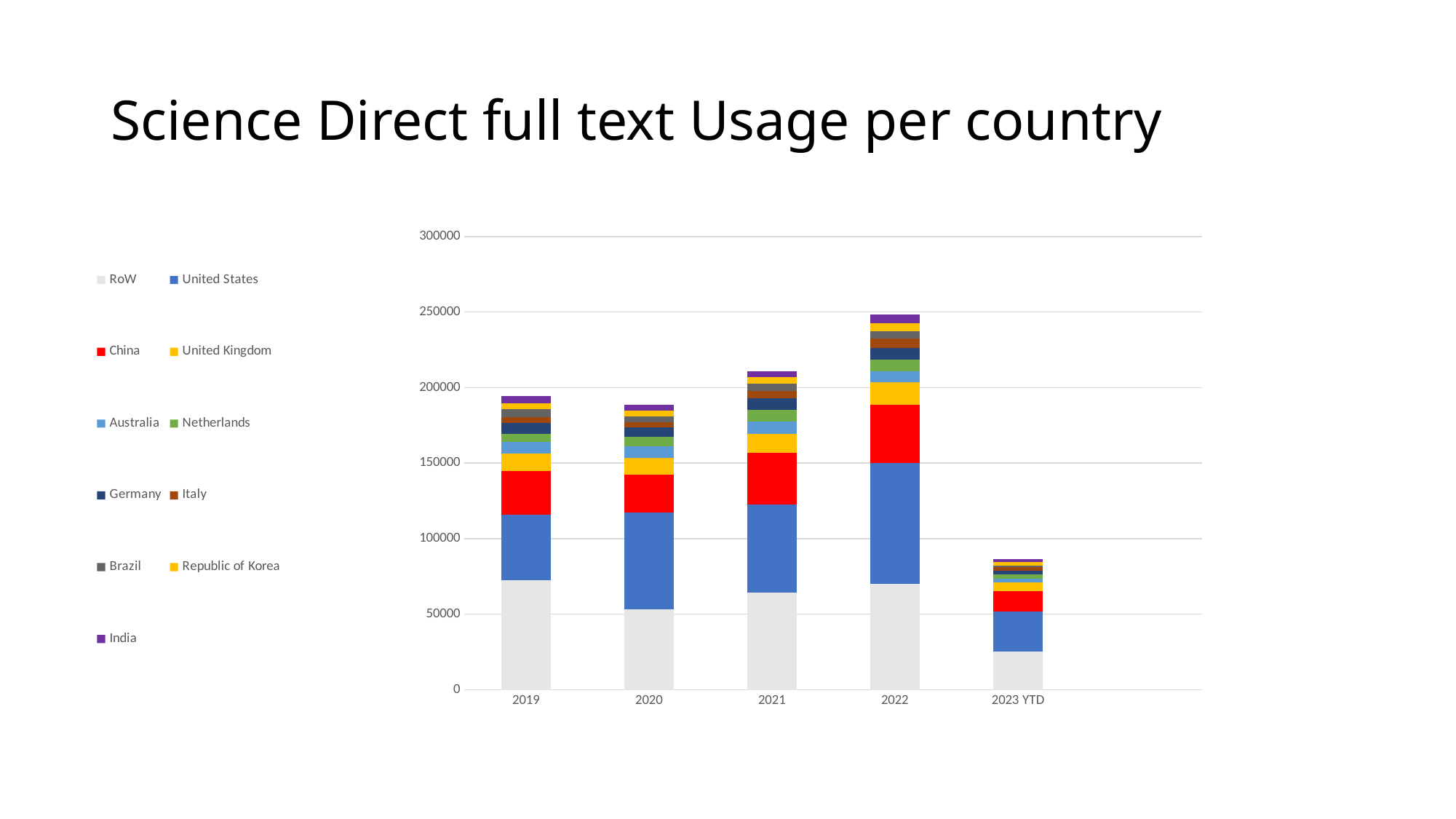
Which category has the shortest stacked bar (lowest total usage)? 2023 YTD Which year has the tallest stacked bar (highest total usage)? 2022 From 2020 to 2022, do the total bar heights rise or fall? rise How many series does the chart's legend list? 11 Which colour represents China in the chart's legend? Red Which has the larger total usage, 2021 or 2022? 2022 Is the total stacked bar for 2023 YTD greater or less than 100000? less Is the total stacked bar for 2022 greater or less than 200000? greater How many years (categories) are shown on the x axis of the chart? 5 What is the title of the slide containing the chart? Science Direct full text Usage per country Is the total stacked bar for 2020 greater or less than 200000? less What kind of chart is shown on the slide? Stacked bar chart